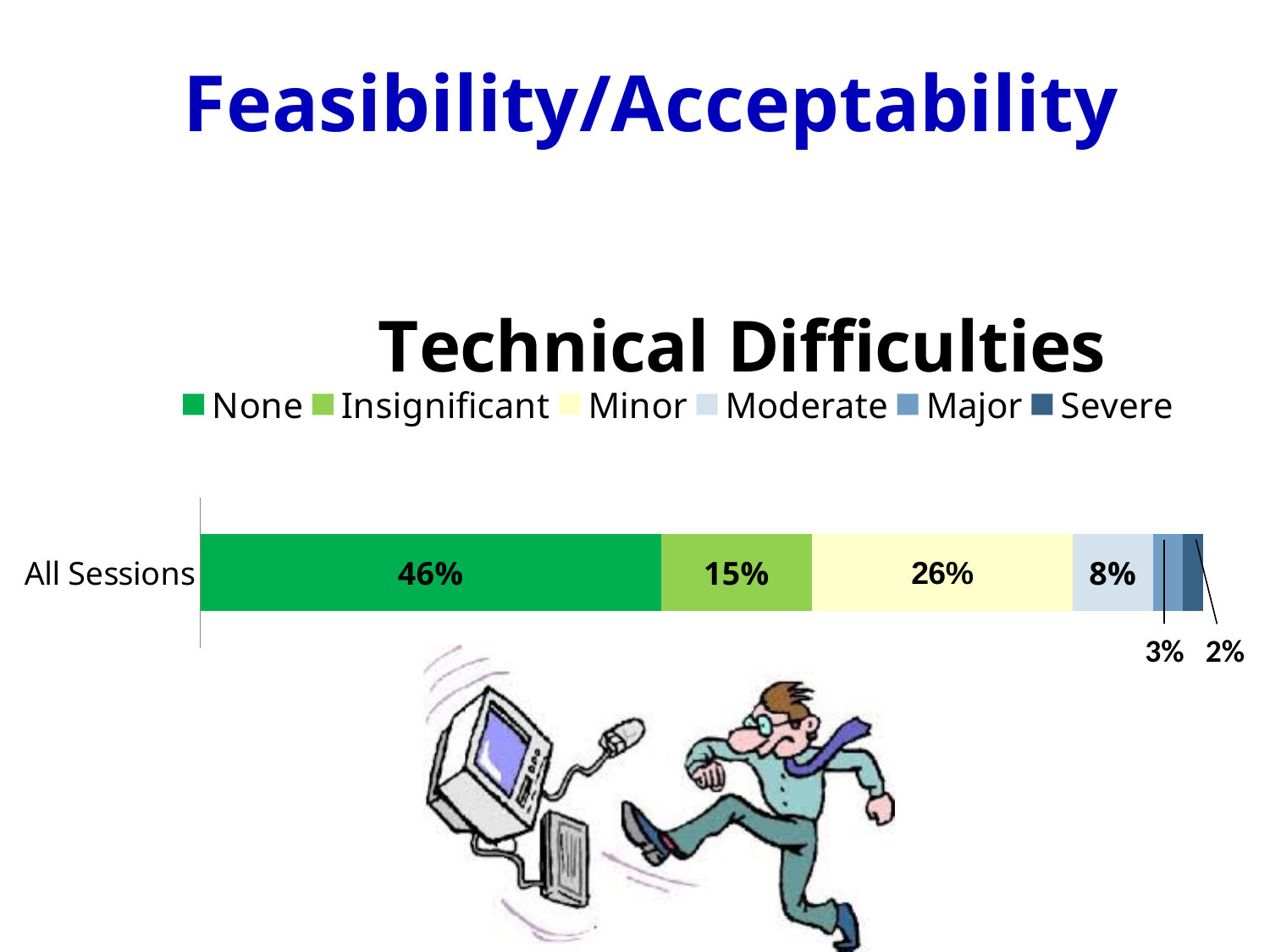
What is the title of the chart? Technical Difficulties What is the total of all segments in the All Sessions bar? 100% What percentage of All Sessions had no technical difficulties (None)? 46% What kind of chart is shown on the slide? Stacked bar chart What is the difference between the Minor and Insignificant shares for All Sessions? 11% What percentage of All Sessions had Severe technical difficulties? 2% What percentage of All Sessions had Minor technical difficulties? 26% Which technical difficulty category has the largest share for All Sessions? None Which is larger for All Sessions, the Moderate share or the Major share? Moderate What percentage of All Sessions had Moderate technical difficulties? 8% Which technical difficulty category has the smallest share for All Sessions? Severe How many series does the legend list? 6